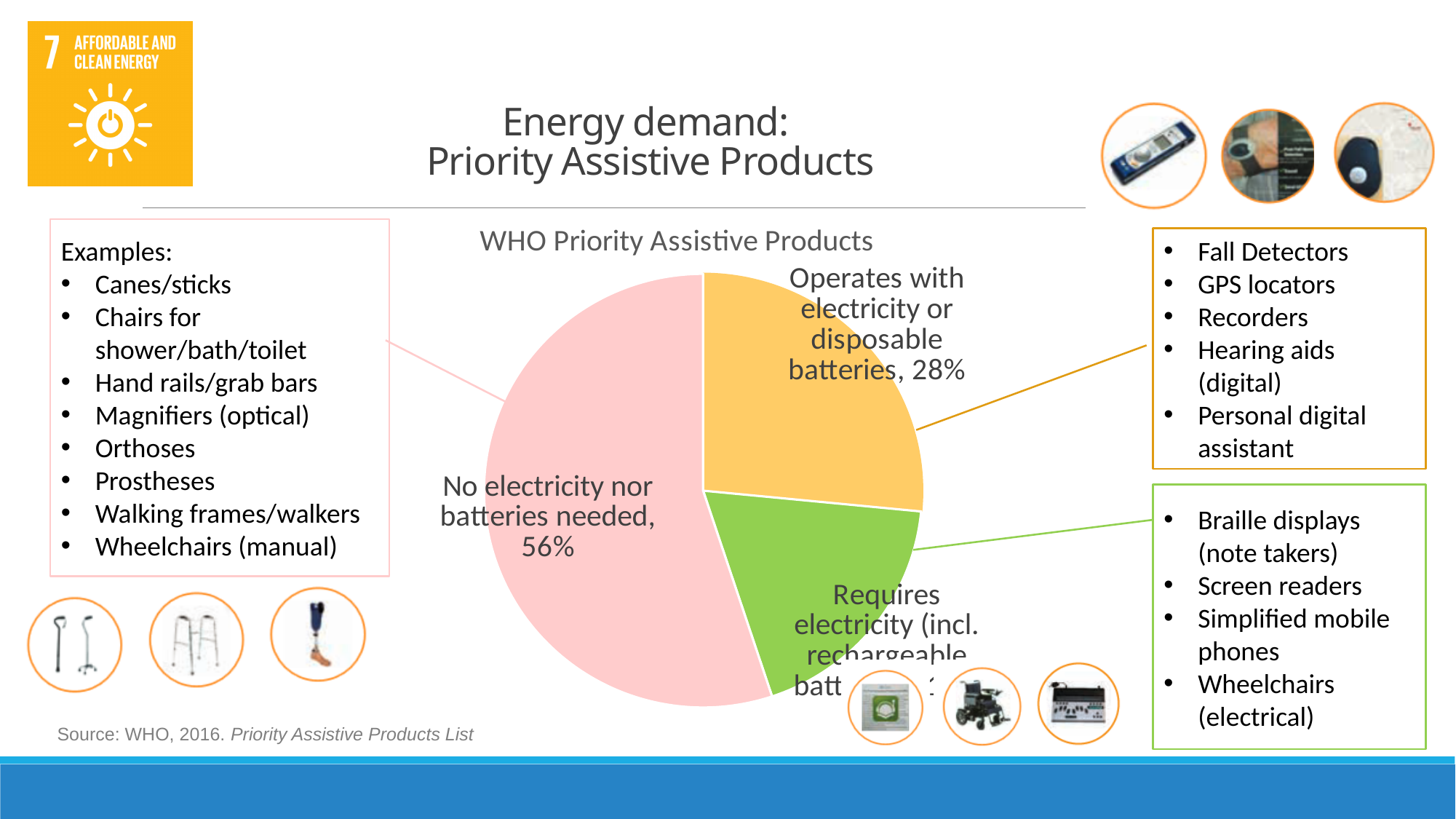
What colour is the slice for 'No electricity nor batteries needed'? pink How many slices does the pie chart have? 3 What is the difference in percentage points between 'No electricity nor batteries needed' and 'Operates with electricity or disposable batteries'? 28 What kind of chart is shown on the slide? pie chart Which category has the smallest slice of the pie? Requires electricity (incl. rechargeable batteries) What share of the pie is 'No electricity nor batteries needed'? 56% Which category has the largest slice of the pie? No electricity nor batteries needed Which is larger: the slice for 'No electricity nor batteries needed' or the slice for 'Operates with electricity or disposable batteries'? No electricity nor batteries needed What percentage is shown for 'Operates with electricity or disposable batteries'? 28% What is the title of the pie chart? WHO Priority Assistive Products